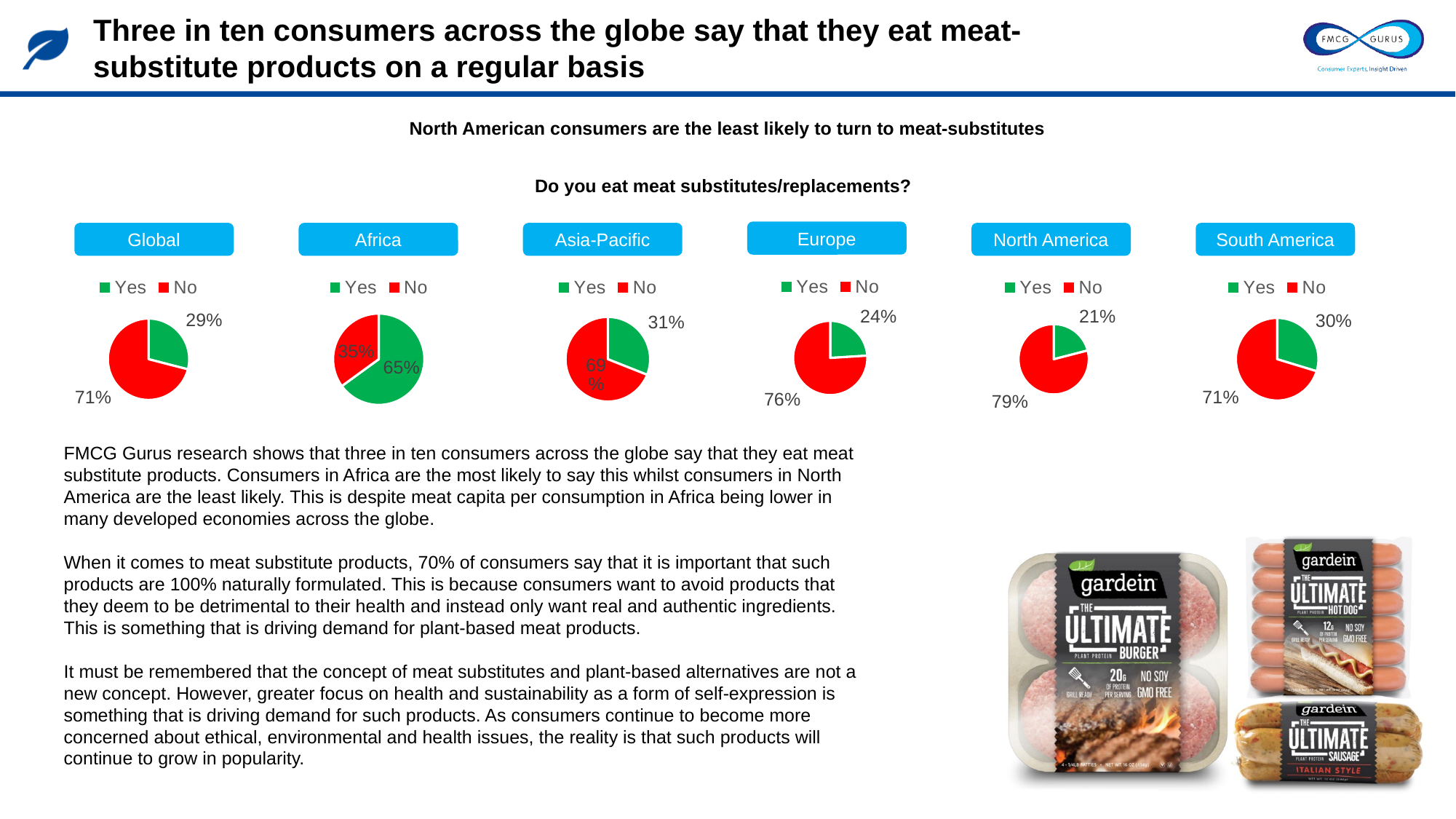
What is the difference between the No share in the North America pie chart and the No share in the Europe pie chart? 3% In the Asia-Pacific pie chart, what percentage of consumers answered Yes? 31% In the South America pie chart, what percentage of consumers answered No? 71% In the Europe pie chart, what percentage of consumers answered No? 76% In the North America pie chart, what percentage of consumers answered Yes? 21% In the Global pie chart, what percentage of consumers answered No? 71% Across the six pie charts, which region has the smallest Yes share? North America How many series does the legend of each pie chart list? 2 In the Global pie chart, what percentage of consumers answered Yes? 29% Across the six pie charts, which region has the largest Yes share? Africa Is the Yes share larger in the Asia-Pacific pie chart or in the Europe pie chart? Asia-Pacific How many pie charts are shown on the slide? 6